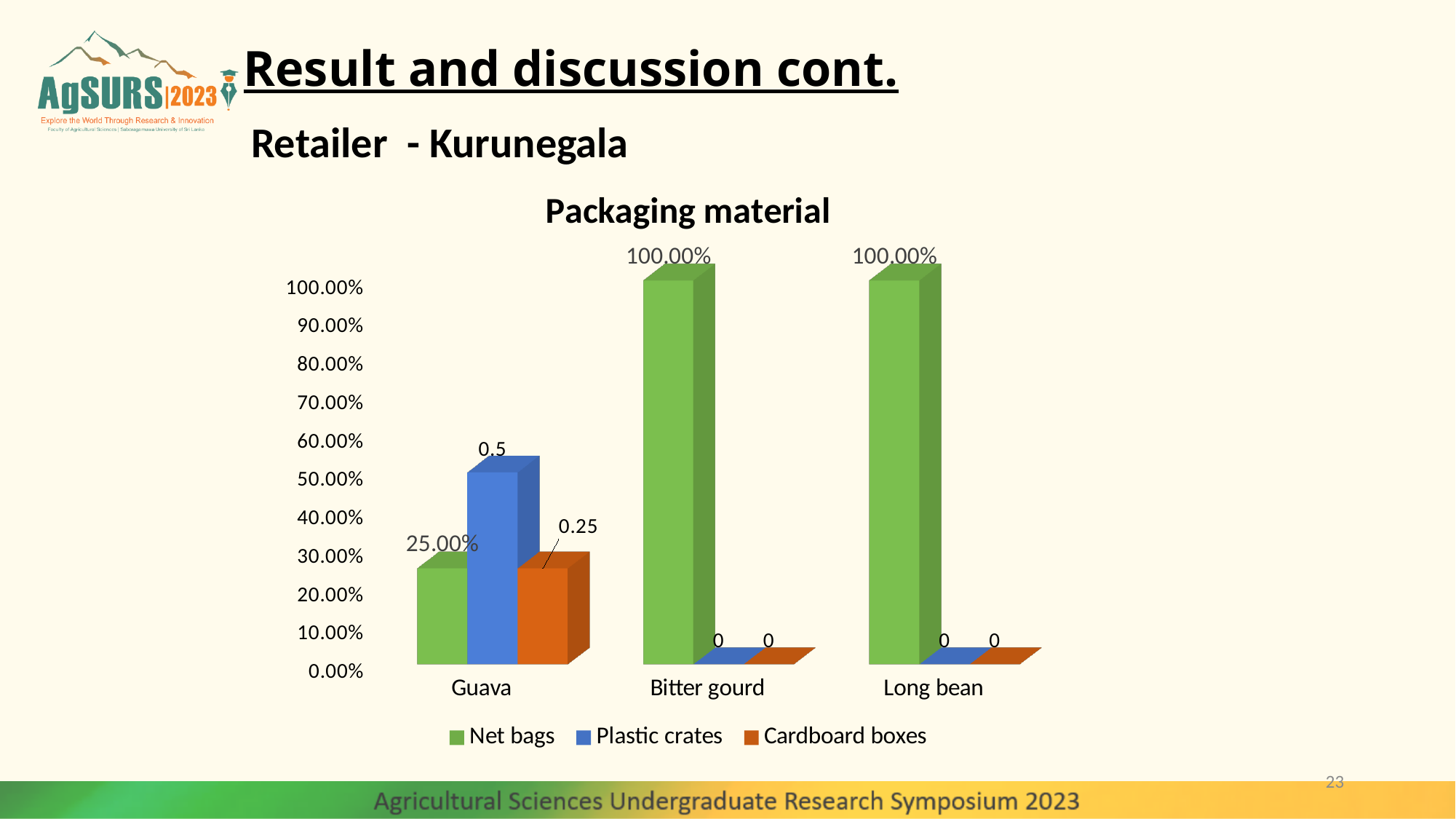
Which category has the lowest value for Net bags? Guava What is the value for Cardboard boxes for Guava? 0.25 How many categories are shown on the x axis? 3 What is the title of the chart? Packaging material Is the value for Net bags for Guava greater or less than 50.00%? less Which packaging material has the highest value for Guava? Plastic crates How many series does the legend list? 3 What is the value for Plastic crates for Guava? 0.5 What kind of chart is shown? bar chart What is the value for Net bags for Bitter gourd? 100.00% What is the value for Net bags for Guava? 25.00% What is the value for Plastic crates for Long bean? 0